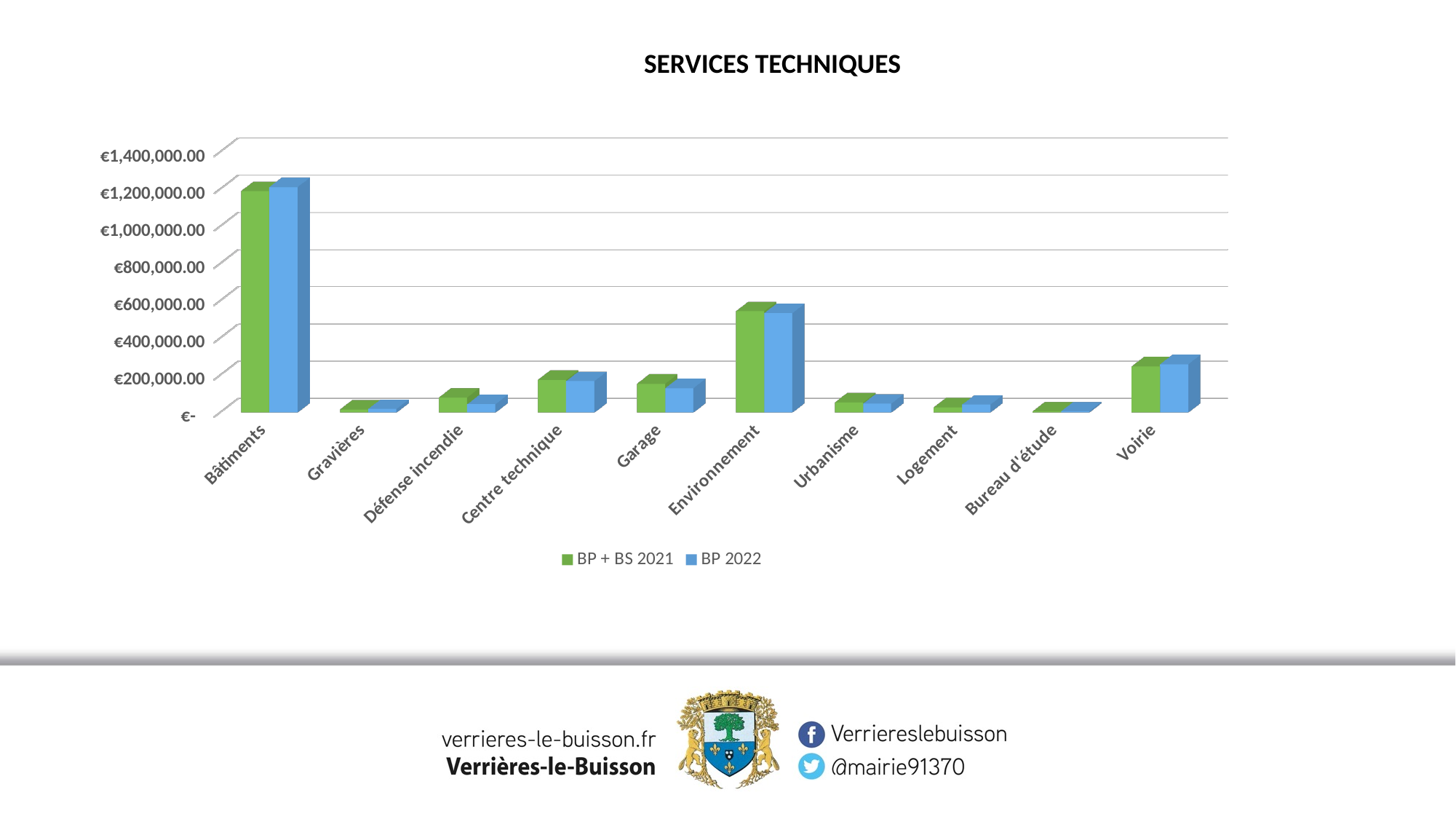
Is the BP 2022 value for Bâtiments greater or less than €1,000,000.00? greater Which has the larger BP 2022 value, Environnement or Voirie? Environnement What is the title of the chart? SERVICES TECHNIQUES Is the BP + BS 2021 value for Urbanisme greater or less than €200,000.00? less Is the BP + BS 2021 value for Environnement greater or less than €400,000.00? greater Which category has the highest value for BP + BS 2021? Bâtiments How many categories are shown on the x axis? 10 Which category has the highest value for BP 2022? Bâtiments How many series does the legend list? 2 Which colour represents the BP 2022 series? Blue What kind of chart is shown on the slide? Bar chart